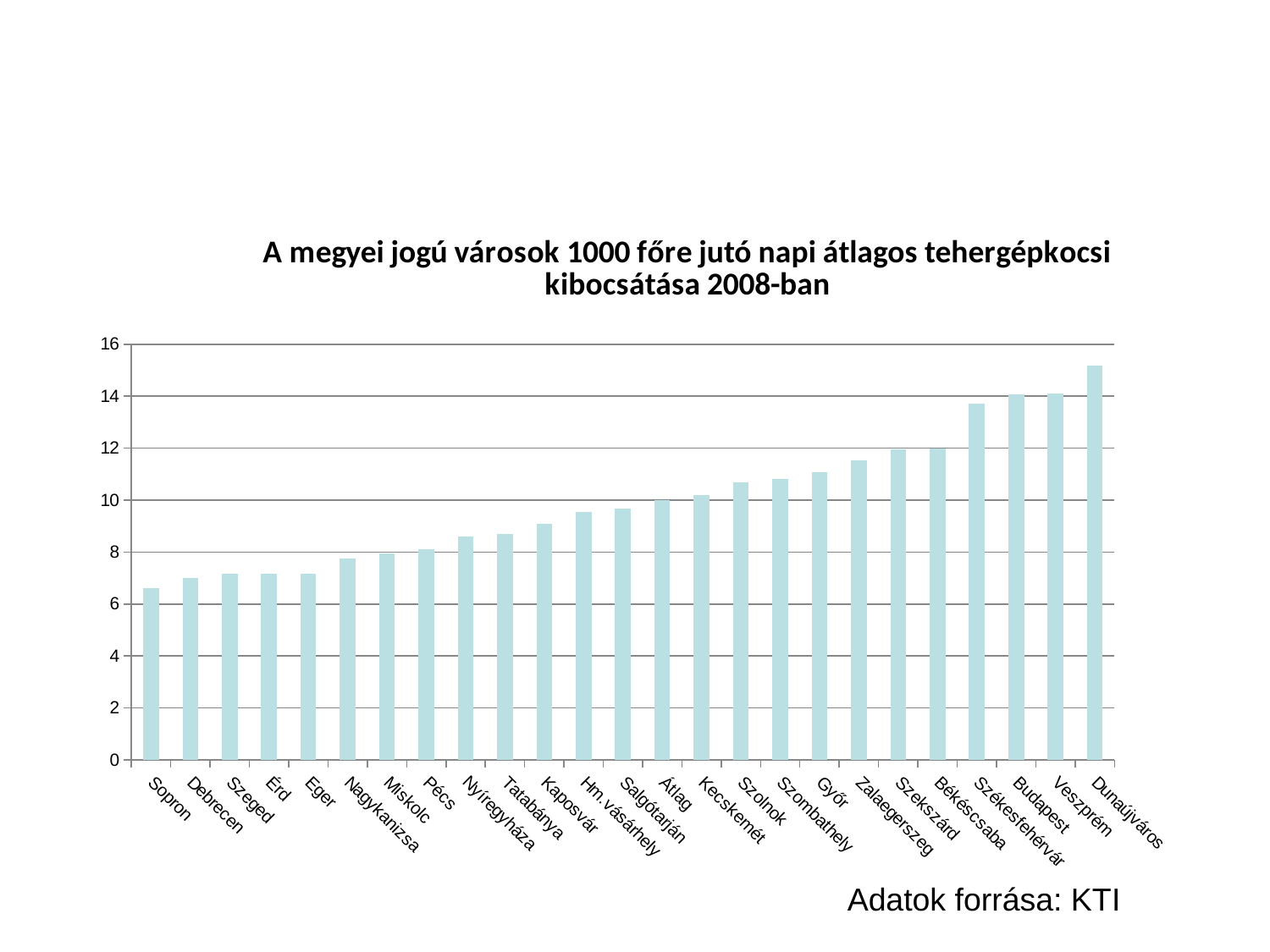
Which category has the lowest value? Sopron Is the value for Budapest greater or less than 12? greater Is the value for Dunaújváros greater or less than 14? greater Is the value for Debrecen greater or less than 8? less Do the values rise or fall from left to right along the x axis? rise Which category has the highest value? Dunaújváros How many cities/categories are plotted on the x axis? 25 What is the title of the chart? A megyei jogú városok 1000 főre jutó napi átlagos tehergépkocsi kibocsátása 2008-ban What kind of chart is shown on the slide? bar chart Which is larger, the value for Győr or the value for Pécs? Győr